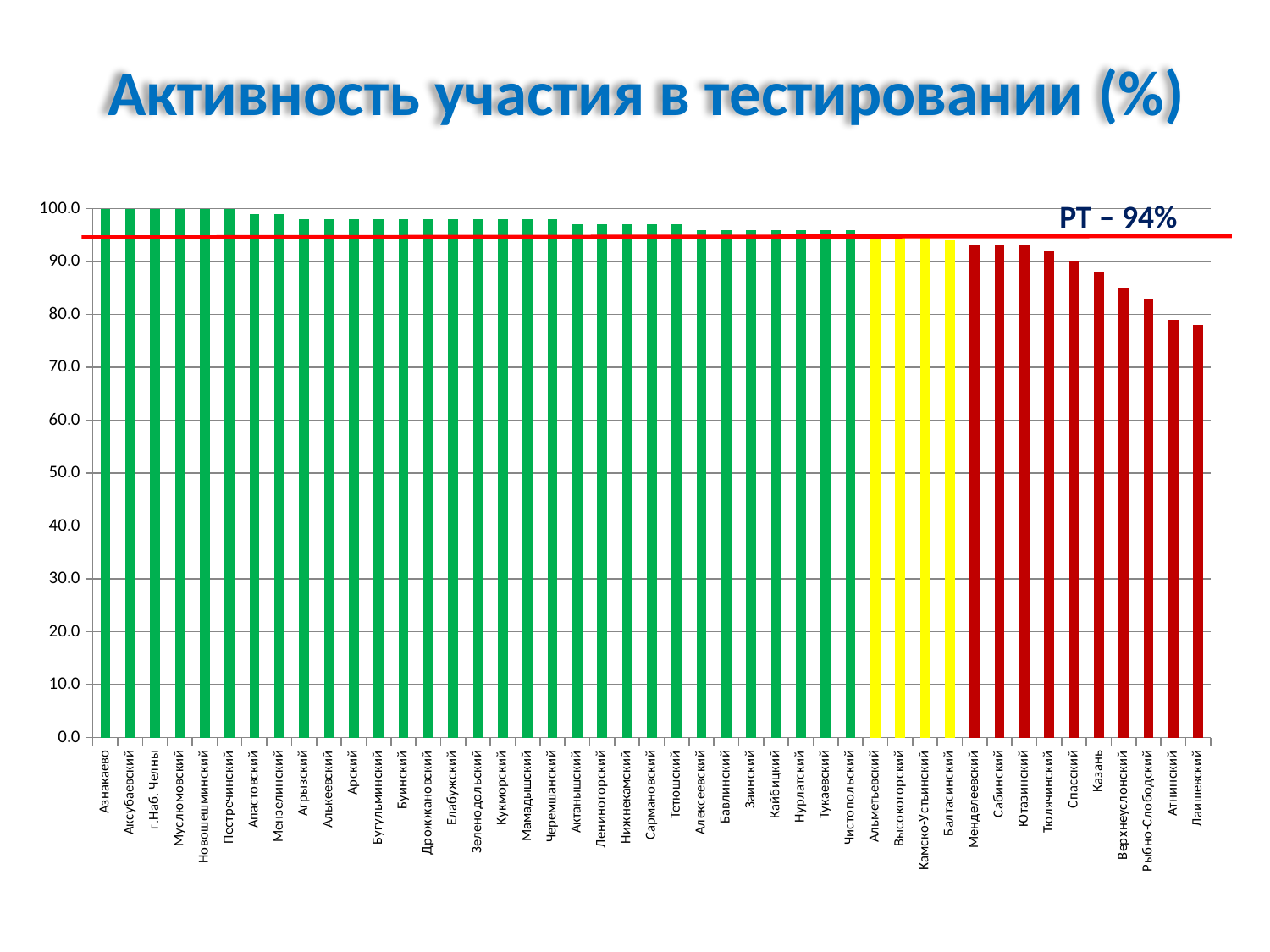
How many categories (districts) are plotted along the x axis? 45 Is the value for Лаишевский greater or less than 80? less What is the chart's title? Активность участия в тестировании (%) Which has the larger value, Азнакаево or Лаишевский? Азнакаево Which has the larger value, Казань or Менделеевский? Менделеевский Do the bar values rise or fall moving from left to right along the x axis? fall Is the value for Рыбно-Слободский greater or less than 80? greater What value does the red horizontal reference line labelled РТ mark? 94% What kind of chart is shown on the slide? bar chart Is the value for Верхнеуслонский greater or less than 90? less